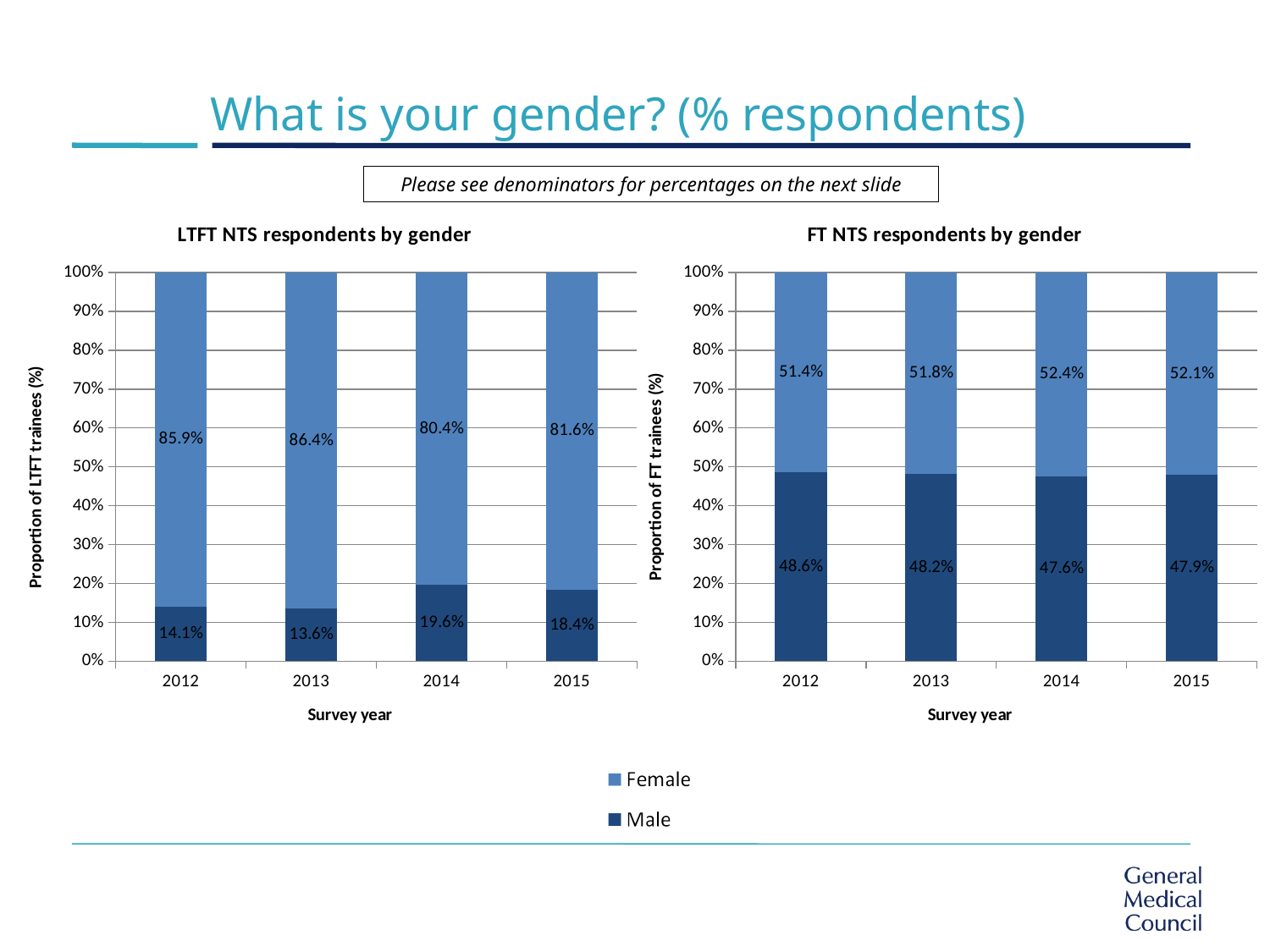
In the 'FT NTS respondents by gender' chart, which survey year has the highest Male value? 2012 In the 'FT NTS respondents by gender' chart, what is the Female value for 2014? 52.4% In the 'LTFT NTS respondents by gender' chart, what is the Male value for 2014? 19.6% How many survey years are shown in the 'LTFT NTS respondents by gender' chart? 4 In the 'LTFT NTS respondents by gender' chart, which survey year has the lowest Female value? 2014 What kind of chart is the 'FT NTS respondents by gender' chart? Stacked bar chart How many series does the legend list? 2 In the 'LTFT NTS respondents by gender' chart, what is the Female value for 2012? 85.9% In the 'FT NTS respondents by gender' chart, is the Female value for 2013 larger than the Male value for 2013? Yes, Female (51.8%) is larger In the 'FT NTS respondents by gender' chart, what is the Male value for 2015? 47.9% In the 'LTFT NTS respondents by gender' chart, which survey year has the highest Male value? 2014 In the 'LTFT NTS respondents by gender' chart, what is the difference between the Female values for 2013 and 2015? 4.8%